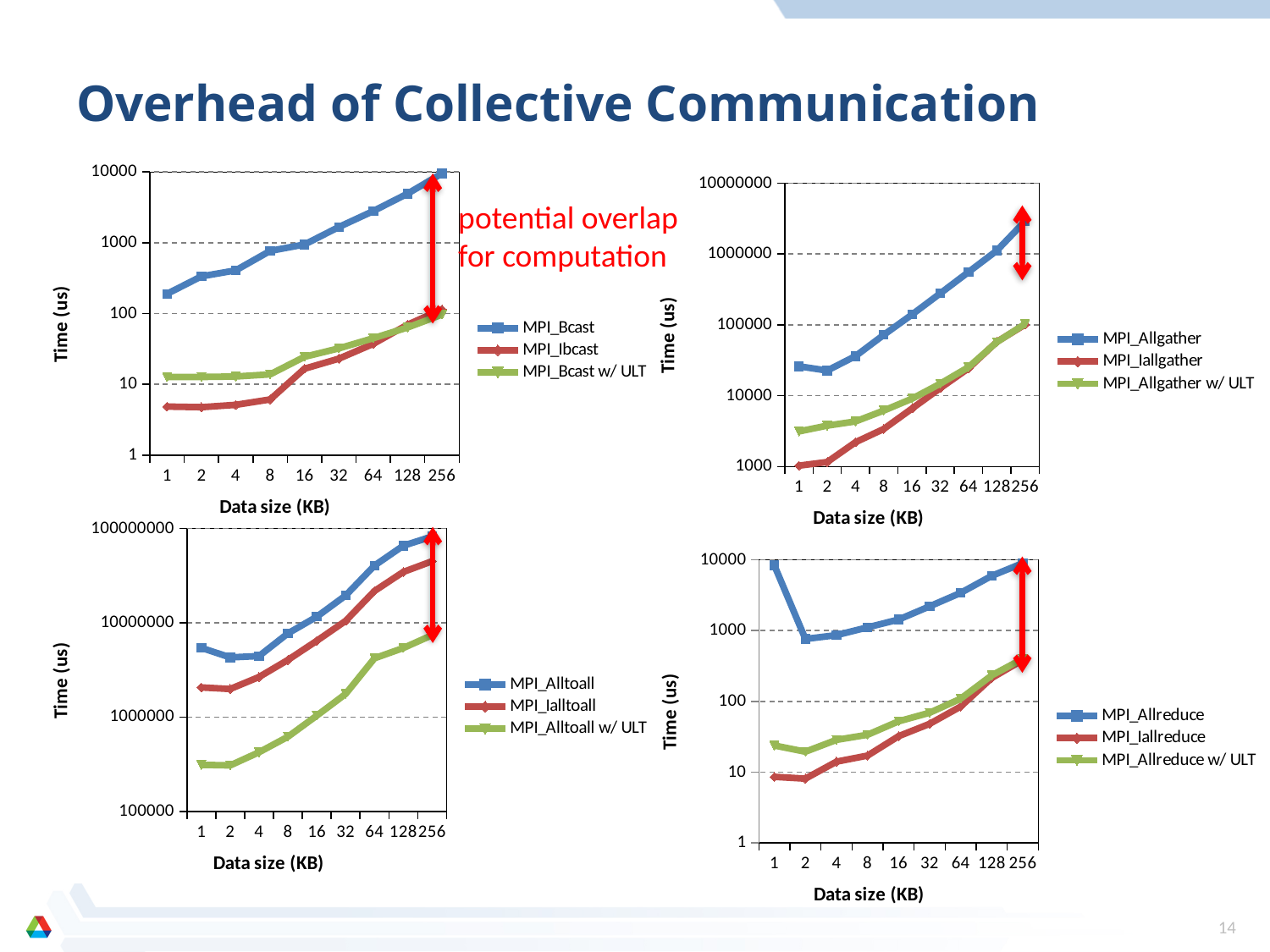
What kind of chart is the top-left chart (MPI_Bcast)? line chart In the bottom-left chart, is the value for MPI_Alltoall w/ ULT at 1 KB greater or less than 1000000? less In the bottom-right chart, is the value for MPI_Allreduce at 2 KB greater or less than 1000? less What does the red annotation text next to the top-left chart say? potential overlap for computation In the top-left chart, is the value for MPI_Bcast at 1 KB greater or less than 100? greater In the top-left chart, does the MPI_Bcast series rise or fall as data size increases? rise How many charts are on the slide? 4 In the bottom-left chart, which series has the larger value at 256 KB, MPI_Alltoall or MPI_Alltoall w/ ULT? MPI_Alltoall In the top-left chart (MPI_Bcast), how many series does the legend list? 3 In the top-right chart (MPI_Allgather), how many data sizes are shown on the x axis? 9